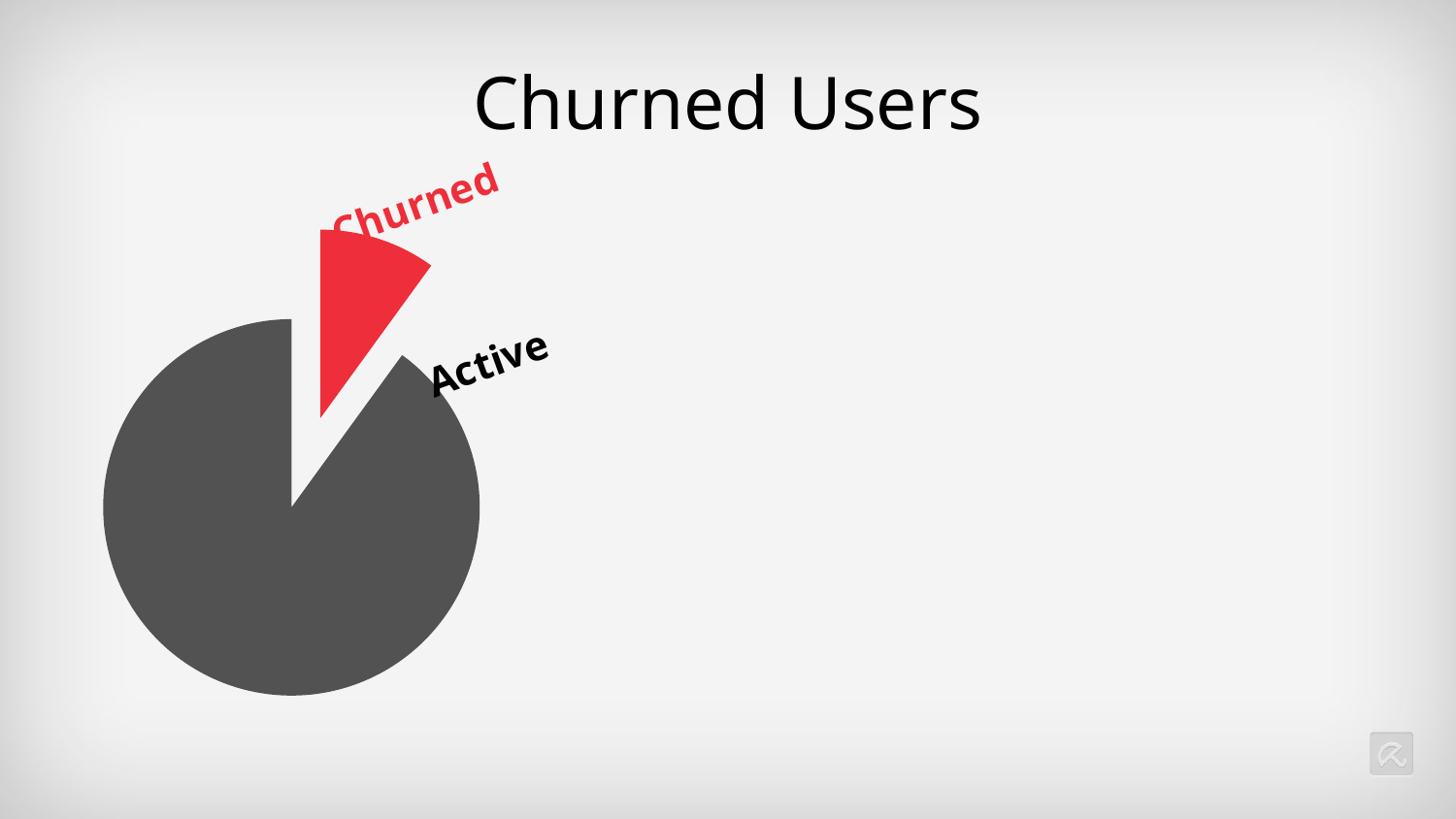
Which slice is larger, Churned or Active? Active Which slice is pulled out (exploded) from the pie? Churned What is the title of the chart? Churned Users What colour is the Churned slice? red Which slice of the pie is the smallest? Churned How many slices does the pie chart have? 2 Which slice of the pie is the largest? Active What kind of chart is shown on the slide? pie chart